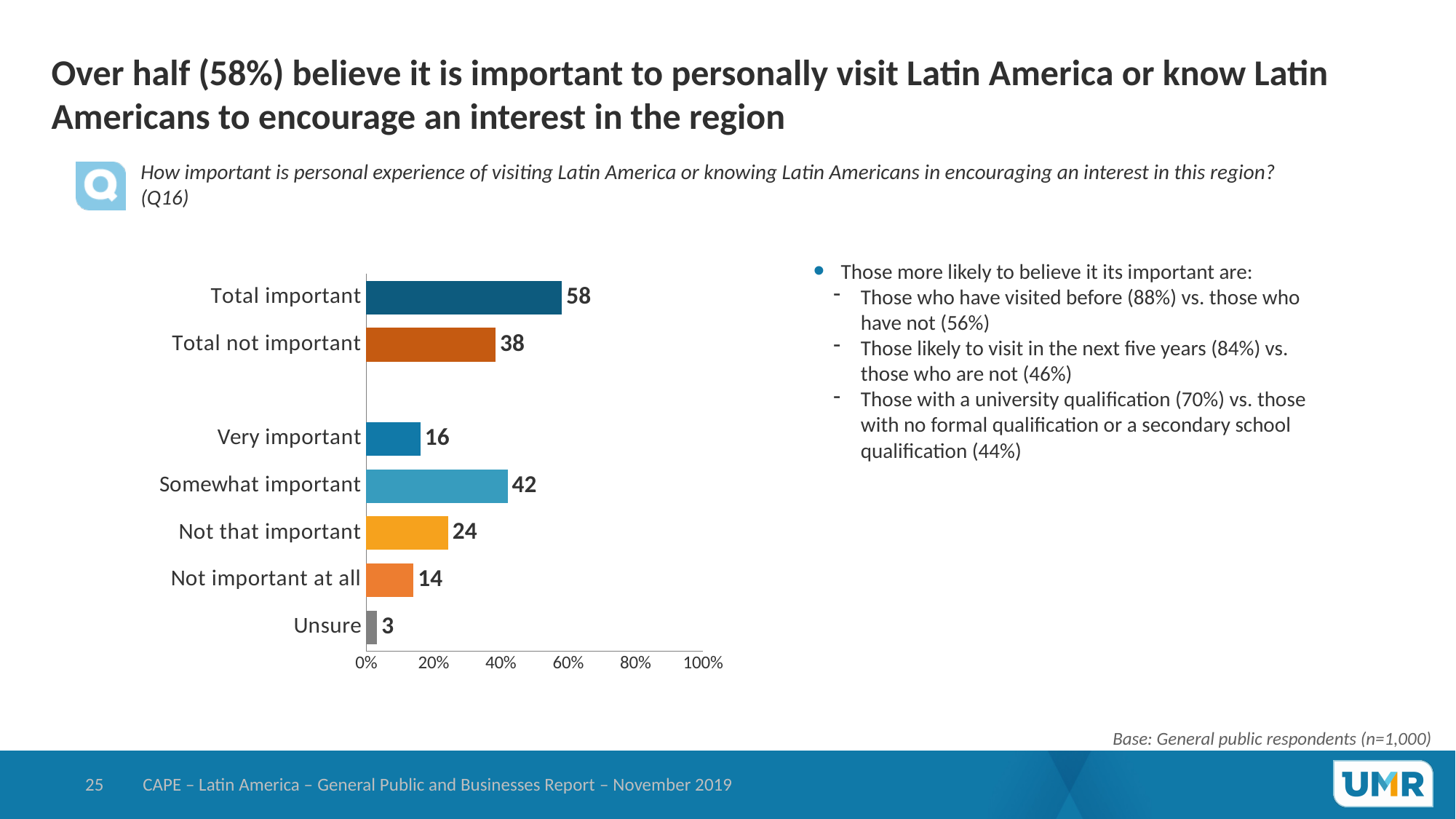
What is the value for Somewhat important? 42 What is the value for Unsure? 3 Is the value for Somewhat important greater or less than 40%? greater What kind of chart is shown on the slide? Bar chart Which is larger, Not that important or Not important at all? Not that important Which category has the highest value? Total important How many categories are shown on the chart? 7 What is the difference between Total important and Total not important? 20 What is the value for Not important at all? 14 What is the difference between Somewhat important and Very important? 26 What is the value for Total important? 58 Which category has the lowest value? Unsure